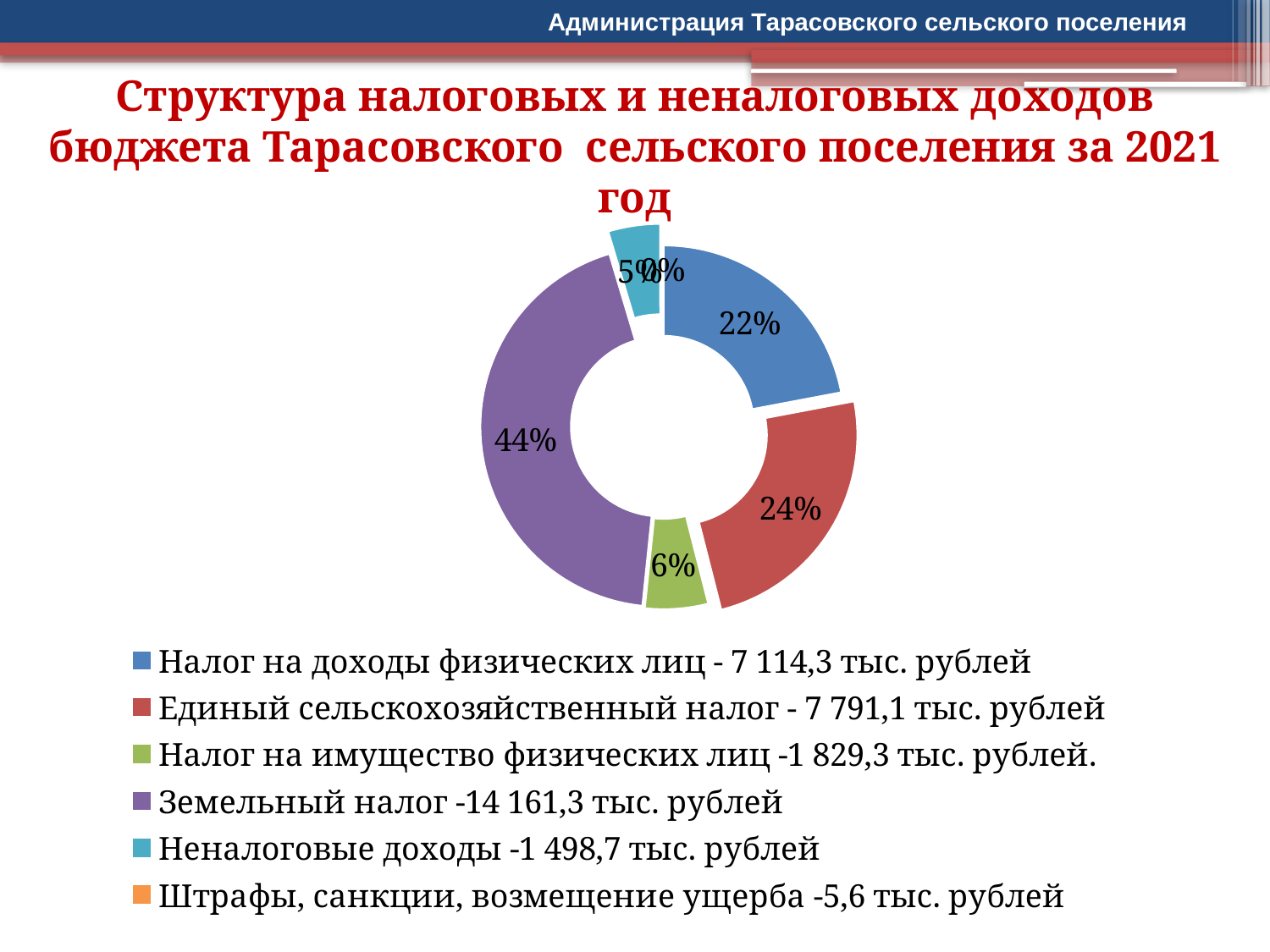
How many categories does the legend list? 6 What share of the chart does Земельный налог represent? 44% What is the difference in percentage points between the share for Земельный налог and the share for Единый сельскохозяйственный налог? 20 percentage points What share of the chart does Единый сельскохозяйственный налог represent? 24% What is the title of the chart on the slide? Структура налоговых и неналоговых доходов бюджета Тарасовского сельского поселения за 2021 год Which category has the smallest share of the chart? Штрафы, санкции, возмещение ущерба Which is larger: the share for Единый сельскохозяйственный налог or for Налог на доходы физических лиц? Единый сельскохозяйственный налог Which category has the largest share of the chart? Земельный налог What share of the chart does Налог на доходы физических лиц represent? 22% What type of chart is shown on the slide? Doughnut (pie) chart According to the legend, what is the amount for Неналоговые доходы? 1 498,7 тыс. рублей